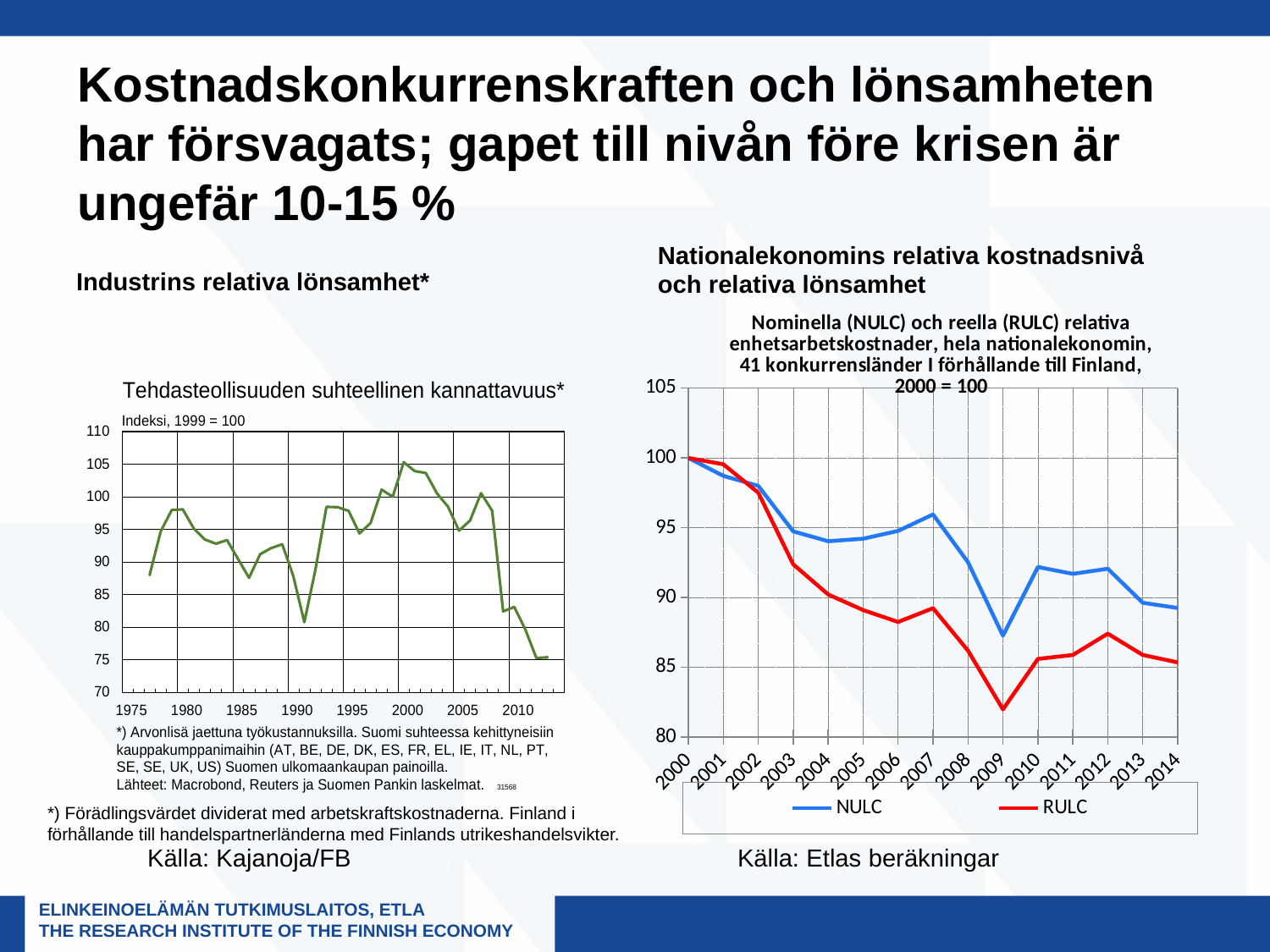
What kind of chart is the left-hand chart, Tehdasteollisuuden suhteellinen kannattavuus? line chart In the right-hand chart, do the NULC values overall rise or fall from 2000 to 2014? fall In the right-hand chart, how many series does the legend list? 2 In the right-hand chart, which series is shown in red? RULC What kind of chart is the right-hand chart (NULC and RULC)? line chart In the right-hand chart, is the value of NULC in 2009 greater or less than 90? less In the right-hand chart, is the value of NULC in 2007 greater or less than 95? greater In the left-hand chart, is the value in 1991 greater or less than 85? less In the right-hand chart, which series is higher in 2009, NULC or RULC? NULC In the right-hand chart, what is the value of NULC in 2000? 100